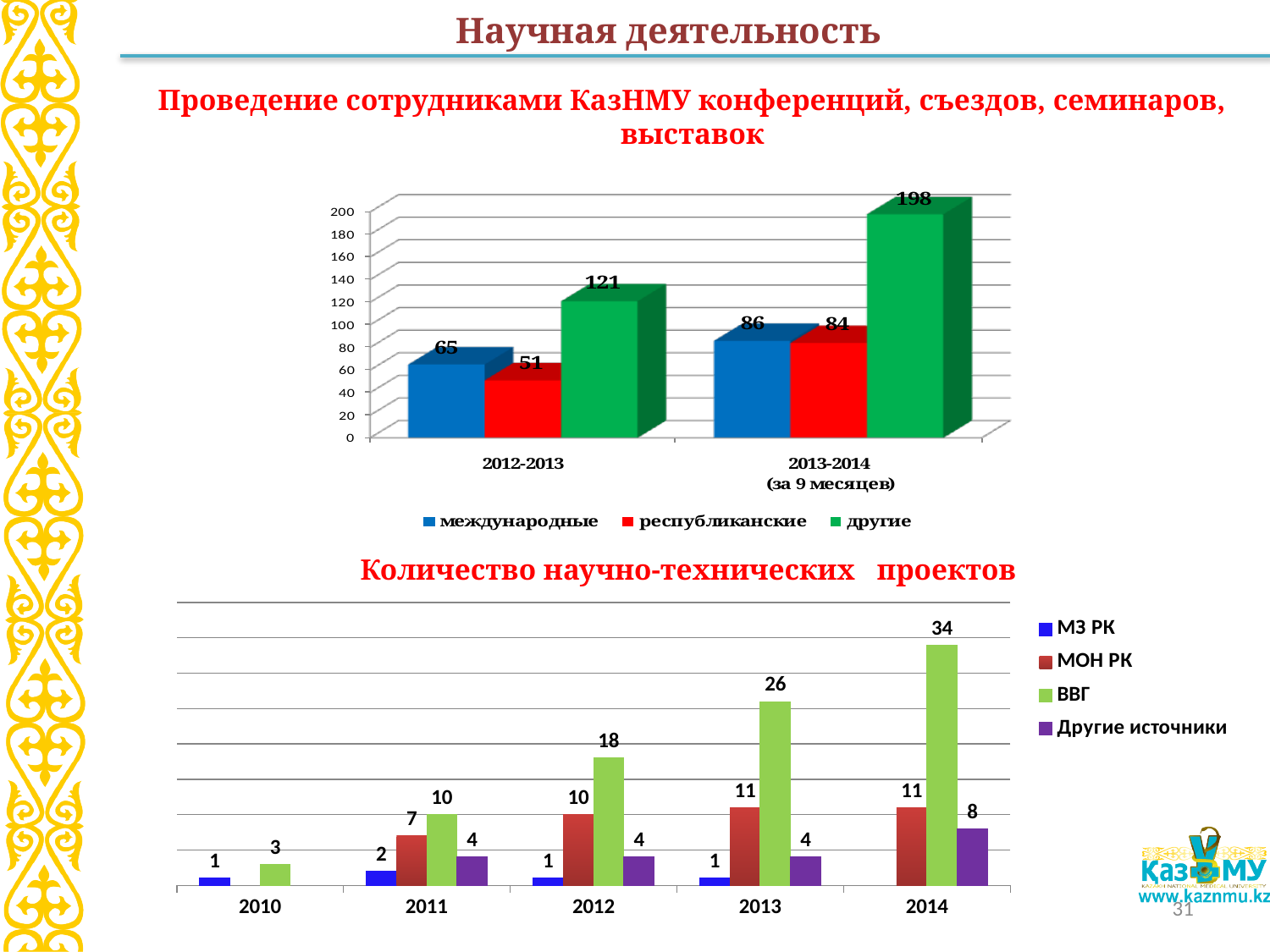
In the top chart (conferences, congresses, seminars, exhibitions), is the value for 'другие' in 2012-2013 greater or less than 100? greater In the bottom chart 'Количество научно-технических проектов', what is the value for ВВГ in 2014? 34 In the bottom chart 'Количество научно-технических проектов', what is the difference between ВВГ in 2013 and ВВГ in 2012? 8 In the bottom chart 'Количество научно-технических проектов', what is the value for МОН РК in 2012? 10 In the top chart (conferences, congresses, seminars, exhibitions), how many series does the legend list? 3 In the top chart (conferences, congresses, seminars, exhibitions), what is the value for 'другие' in 2013-2014 (за 9 месяцев)? 198 In the top chart (conferences, congresses, seminars, exhibitions), by how much did 'международные' increase from 2012-2013 to 2013-2014? 21 In the bottom chart 'Количество научно-технических проектов', how many years are shown on the x axis? 5 In the bottom chart 'Количество научно-технических проектов', which year has the highest value for ВВГ? 2014 In the top chart (conferences, congresses, seminars, exhibitions), which series has the highest value in 2012-2013? другие In the top chart (conferences, congresses, seminars, exhibitions), what is the value for 'республиканские' in 2012-2013? 51 In the bottom chart 'Количество научно-технических проектов', does the value for ВВГ rise or fall from 2010 to 2014? rise